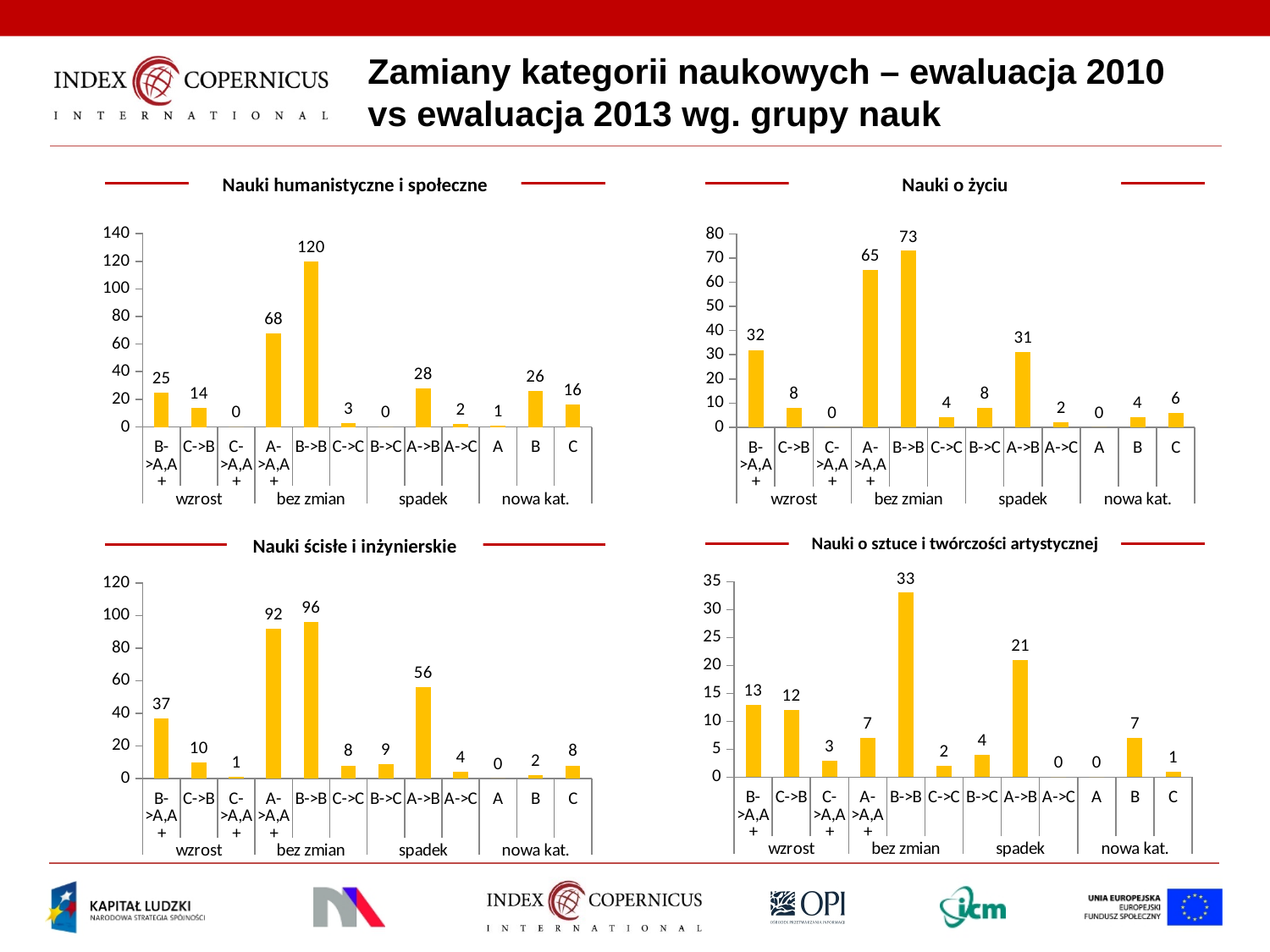
How many categories are plotted in the chart titled "Nauki o sztuce i twórczości artystycznej"? 12 In the chart titled "Nauki ścisłe i inżynierskie", what is the difference between the values for B->B and A->A,A+? 4 In the chart titled "Nauki ścisłe i inżynierskie", what is the value for A->B? 56 In the chart titled "Nauki humanistyczne i społeczne", what is the value for B->B? 120 In the chart titled "Nauki o sztuce i twórczości artystycznej", which is larger, the value for B->A,A+ or the value for C->B? B->A,A+ In the chart titled "Nauki o sztuce i twórczości artystycznej", what is the value for B->B? 33 In the chart titled "Nauki o życiu", what is the total of the values for A, B and C under "nowa kat."? 10 In the chart titled "Nauki humanistyczne i społeczne", which category has the highest value? B->B In the chart titled "Nauki o życiu", which is larger, the value for B->A,A+ or the value for A->B? B->A,A+ In the chart titled "Nauki humanistyczne i społeczne", what is the difference between the values for A->A,A+ and A->B? 40 What type of chart is the chart titled "Nauki ścisłe i inżynierskie"? Bar chart In the chart titled "Nauki o życiu", what is the value for A->A,A+? 65